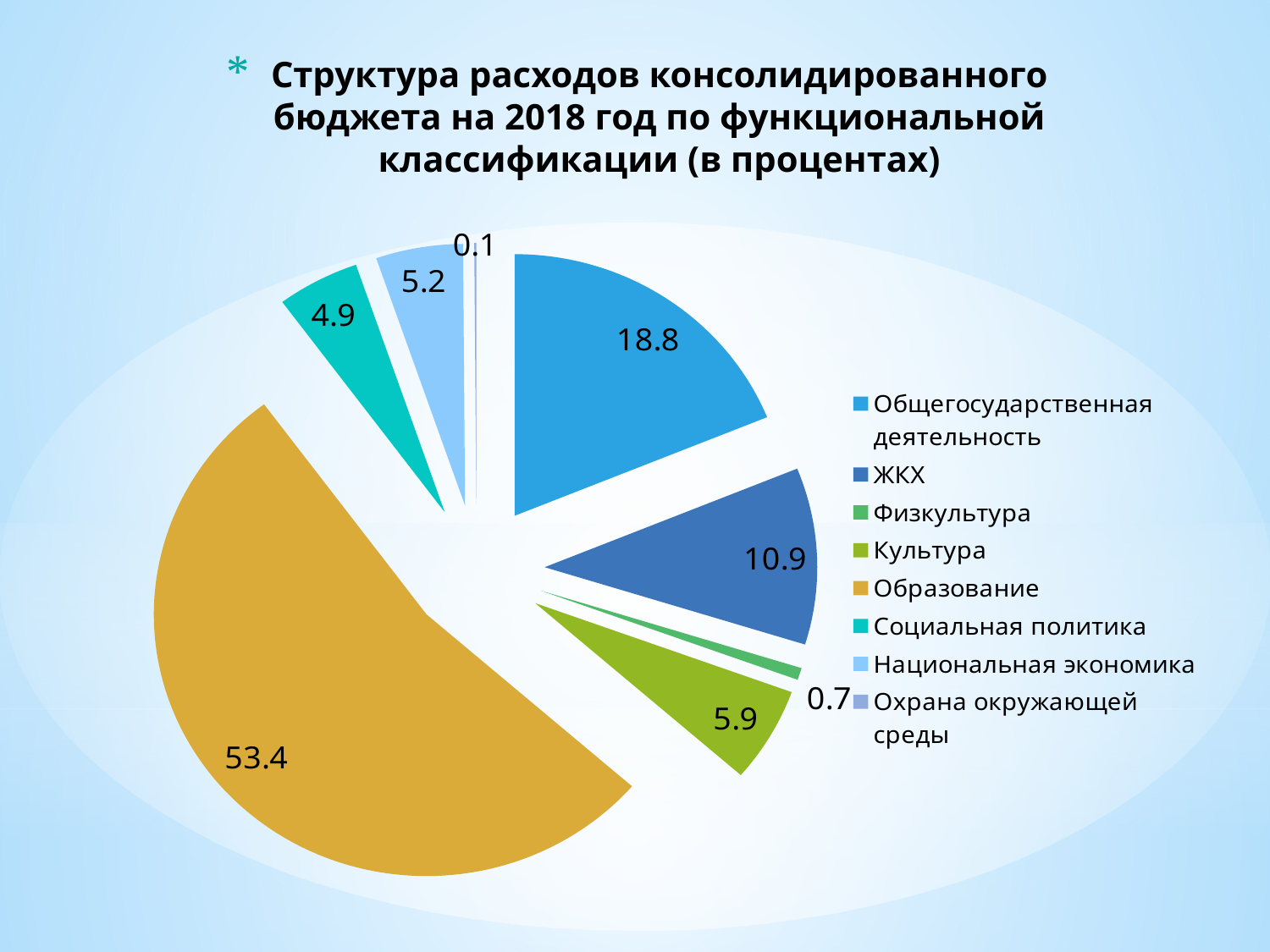
What colour is the slice for Образование? gold What is the value for Образование? 53.4 Which is larger, the value for Культура or the value for Национальная экономика? Культура What is the difference between the values for Общегосударственная деятельность and ЖКХ? 7.9 What is the value for Охрана окружающей среды? 0.1 Which category has the largest share of the pie? Образование What is the value for ЖКХ? 10.9 What kind of chart is shown on the slide? pie chart What is the value for Социальная политика? 4.9 How many categories does the legend list? 8 What is the value for Общегосударственная деятельность? 18.8 Which category has the smallest share of the pie? Охрана окружающей среды